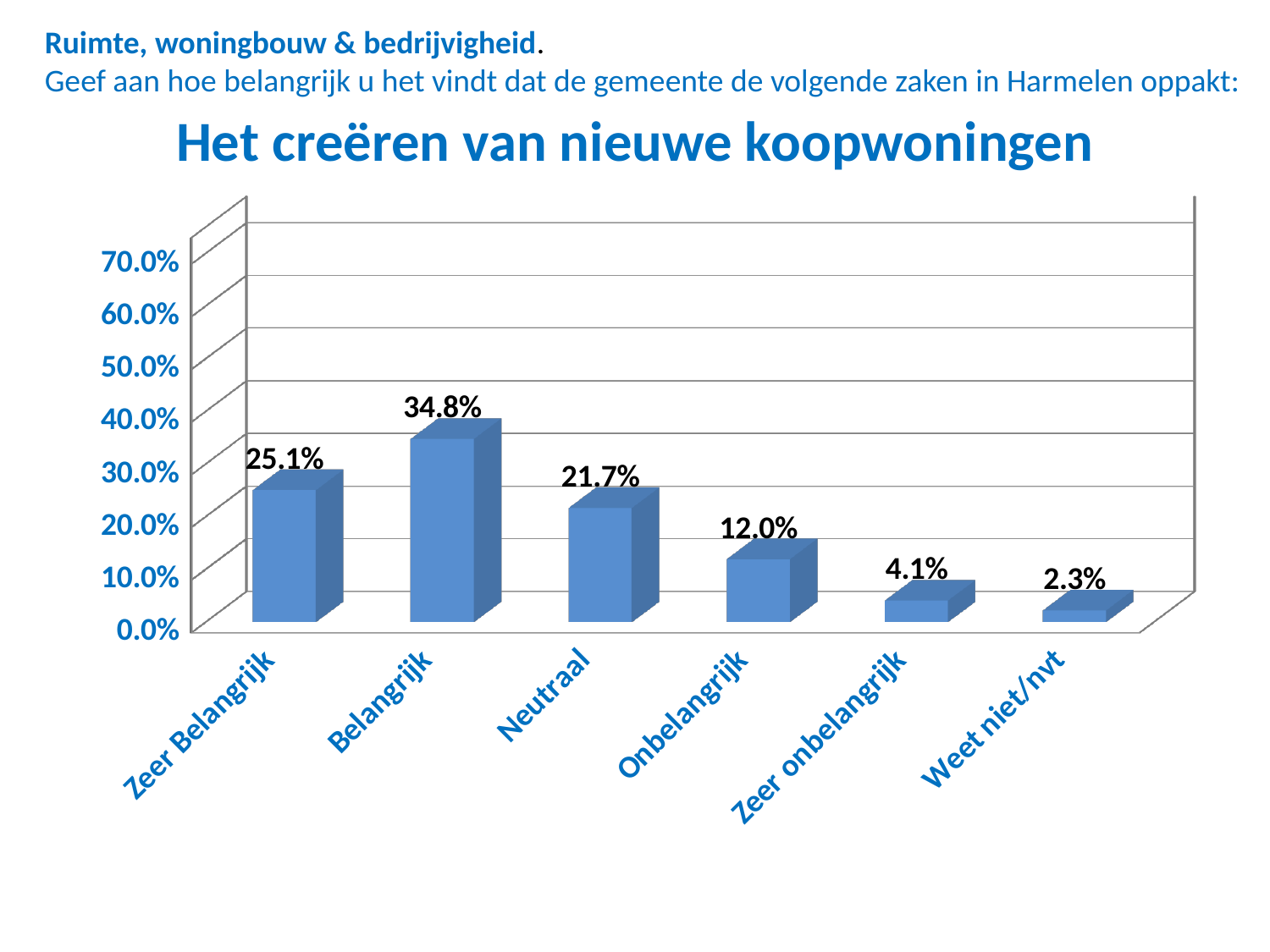
What is the title of the chart? Het creëren van nieuwe koopwoningen What kind of chart is shown on the slide? bar chart Which is larger, the value for Neutraal or the value for Onbelangrijk? Neutraal What is the value for Zeer Belangrijk? 25.1% What is the value for Belangrijk? 34.8% Which category has the highest value? Belangrijk What is the value for Onbelangrijk? 12.0% How many categories are shown on the x axis? 6 Is the value for Zeer onbelangrijk greater or less than 10.0%? less What is the value for Weet niet/nvt? 2.3% What is the difference between the values for Belangrijk and Zeer Belangrijk? 9.7% Which category has the lowest value? Weet niet/nvt